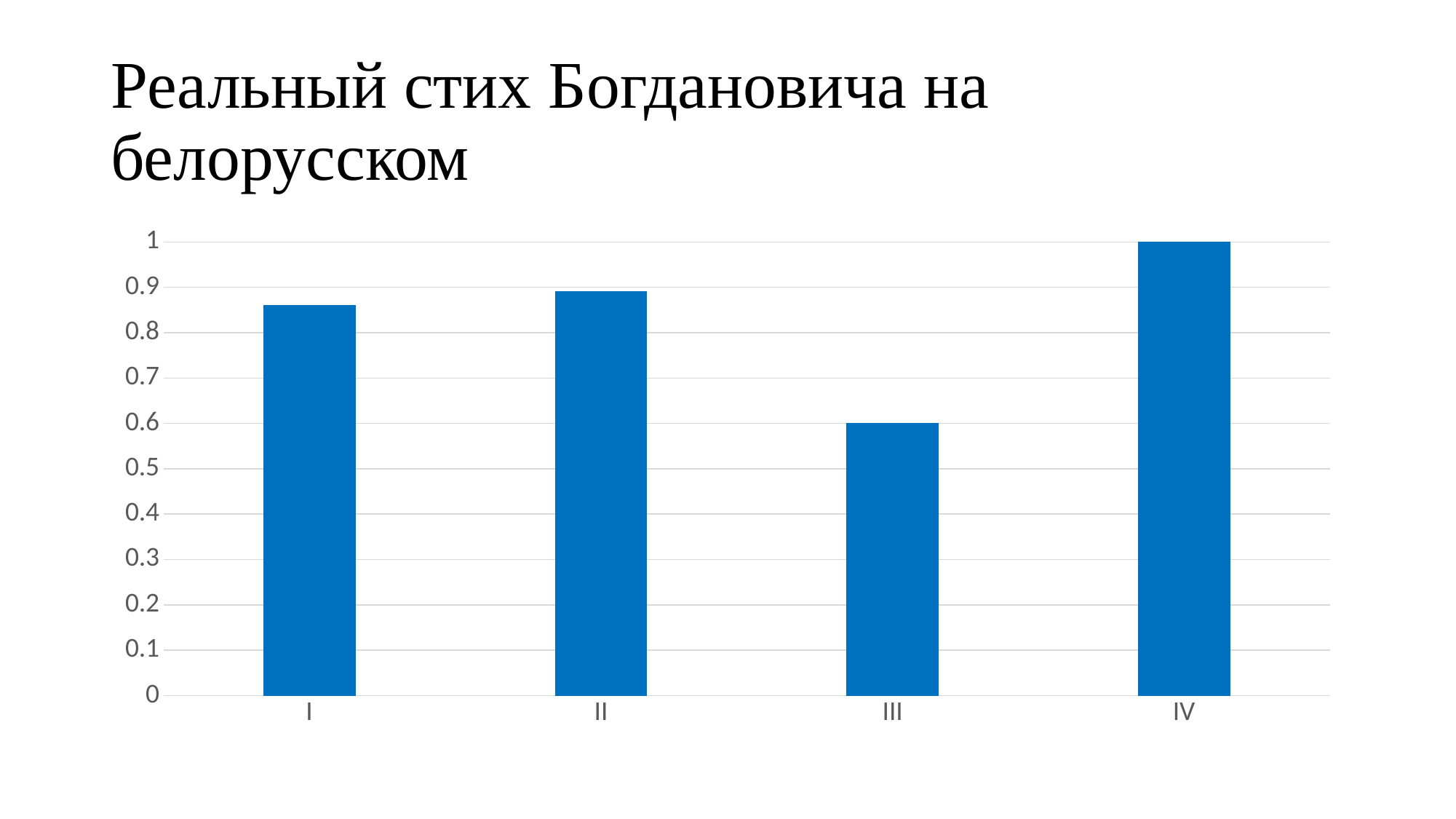
Is the value for II greater or less than 0.8? greater What is the title of the slide containing the chart? Реальный стих Богдановича на белорусском Is the value for I greater or less than 0.9? less Which is larger, the value for I or the value for III? I What is the difference between the values for IV and III? 0.4 How many categories are shown on the x axis of the chart? 4 Which category has the lowest bar? III What kind of chart is shown on the slide? bar chart What is the value for category IV? 1 What is the value for category III? 0.6 Is the value for I greater or less than 0.8? greater Which category has the highest bar? IV